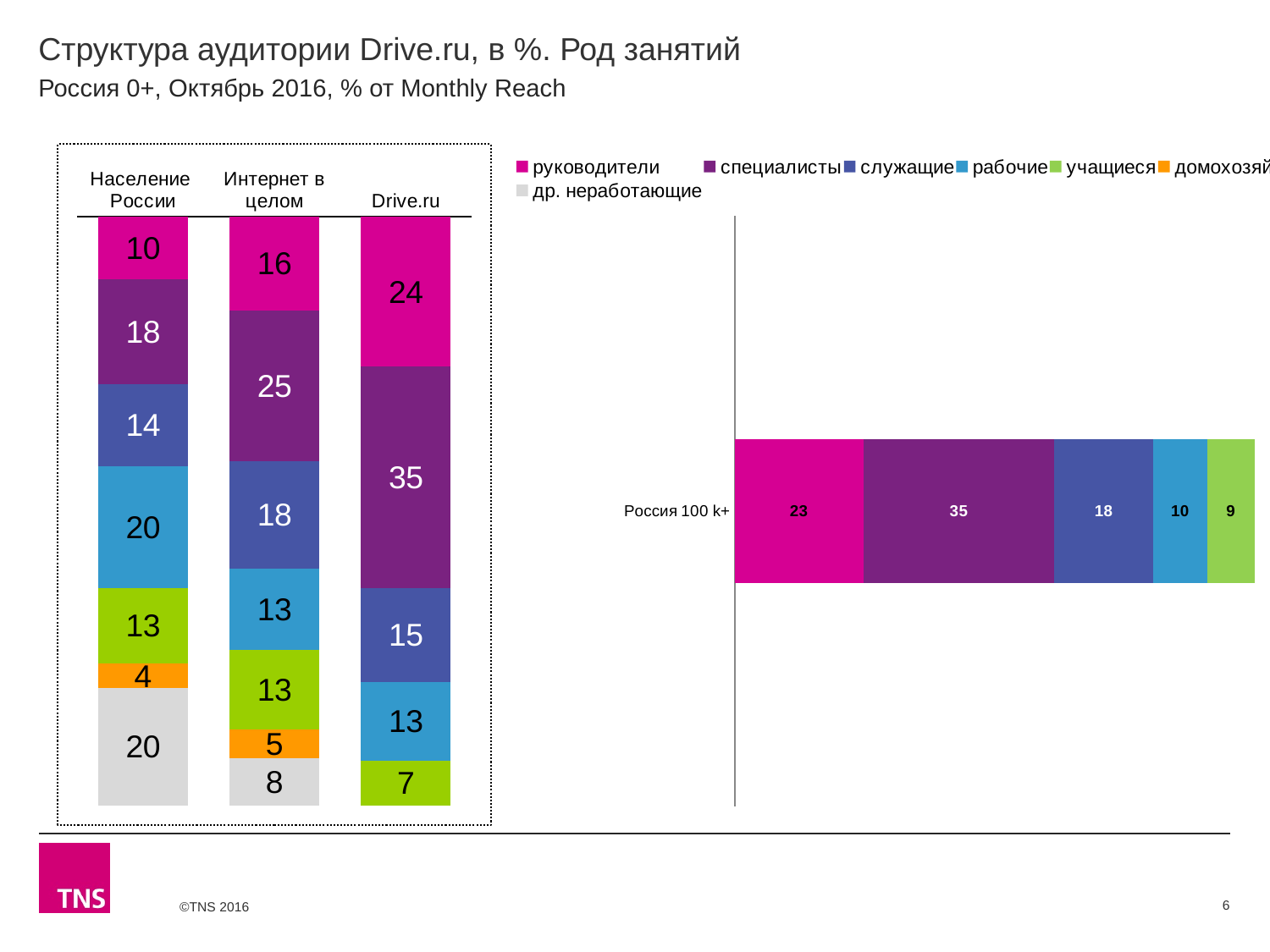
How many bars (categories) does the left chart show? 3 What type of chart is the right chart (Россия 100 k+)? Stacked bar chart In the left chart, what is the value for специалисты in the Drive.ru bar? 35 In the left chart, what is the value for рабочие in the Интернет в целом bar? 13 In the left chart, what is the difference between the руководители values for Drive.ru and Население России? 14 In the left chart, which segment is the largest in the Drive.ru bar? специалисты How many series does the legend list? 7 In the left chart, which is larger: учащиеся for Drive.ru or учащиеся for Интернет в целом? Интернет в целом In the left chart, what is the value for руководители in the Население России bar? 10 In the right chart (Россия 100 k+), what is the value for служащие? 18 In the right chart (Россия 100 k+), what is the total of all segments in the bar? 95 In the left chart, which segment is the smallest in the Население России bar? домохозяйки